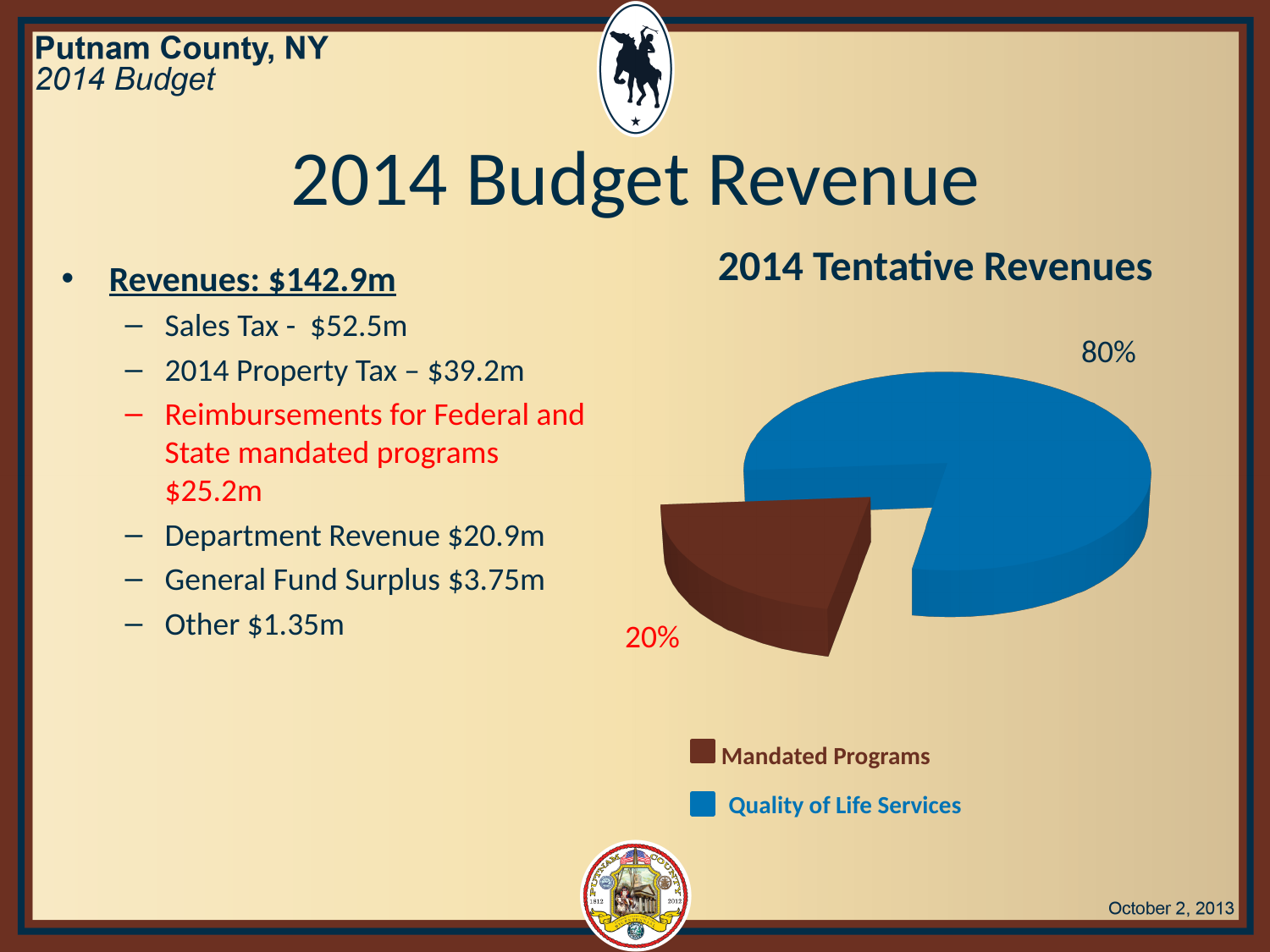
What type of chart is shown on the slide? Pie chart Which slice of the pie is the largest? Quality of Life Services Which is larger, the Mandated Programs slice or the Quality of Life Services slice? Quality of Life Services What share of the pie does the Quality of Life Services slice represent? 80% How many slices does the pie chart have? 2 What percentage of the pie is Quality of Life Services? 80% What percentage of the pie is Mandated Programs? 20% Which slice of the pie is the smallest? Mandated Programs How many entries does the legend list? 2 What colour is the Mandated Programs slice? Brown What is the difference in percentage points between the Quality of Life Services slice and the Mandated Programs slice? 60 What is the title of the chart? 2014 Tentative Revenues